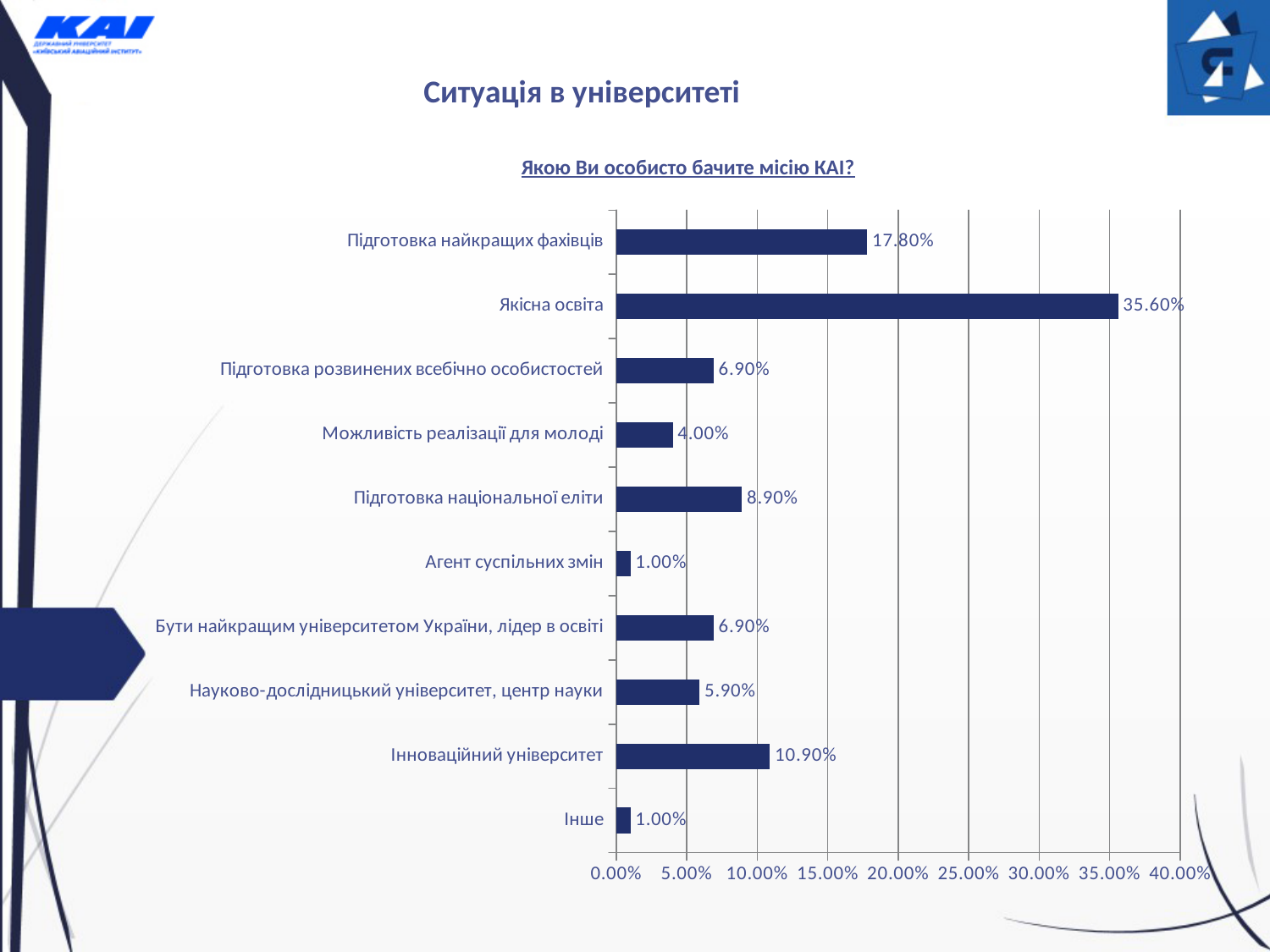
What is the difference between "Якісна освіта" and "Підготовка найкращих фахівців"? 17.80% How many categories are shown in the chart? 10 Is the value for "Підготовка найкращих фахівців" greater or less than 15.00%? greater Which is larger: "Підготовка національної еліти" or "Можливість реалізації для молоді"? Підготовка національної еліти What is the value for "Підготовка національної еліти"? 8.90% What is the maximum value shown on the x axis? 40.00% What is the value for "Інноваційний університет"? 10.90% What is the title of the chart? Якою Ви особисто бачите місію КАІ? What kind of chart is shown on the slide? bar chart Which category has the highest value? Якісна освіта What is the value for "Якісна освіта"? 35.60% What is the difference between "Інноваційний університет" and "Науково-дослідницький університет, центр науки"? 5.00%